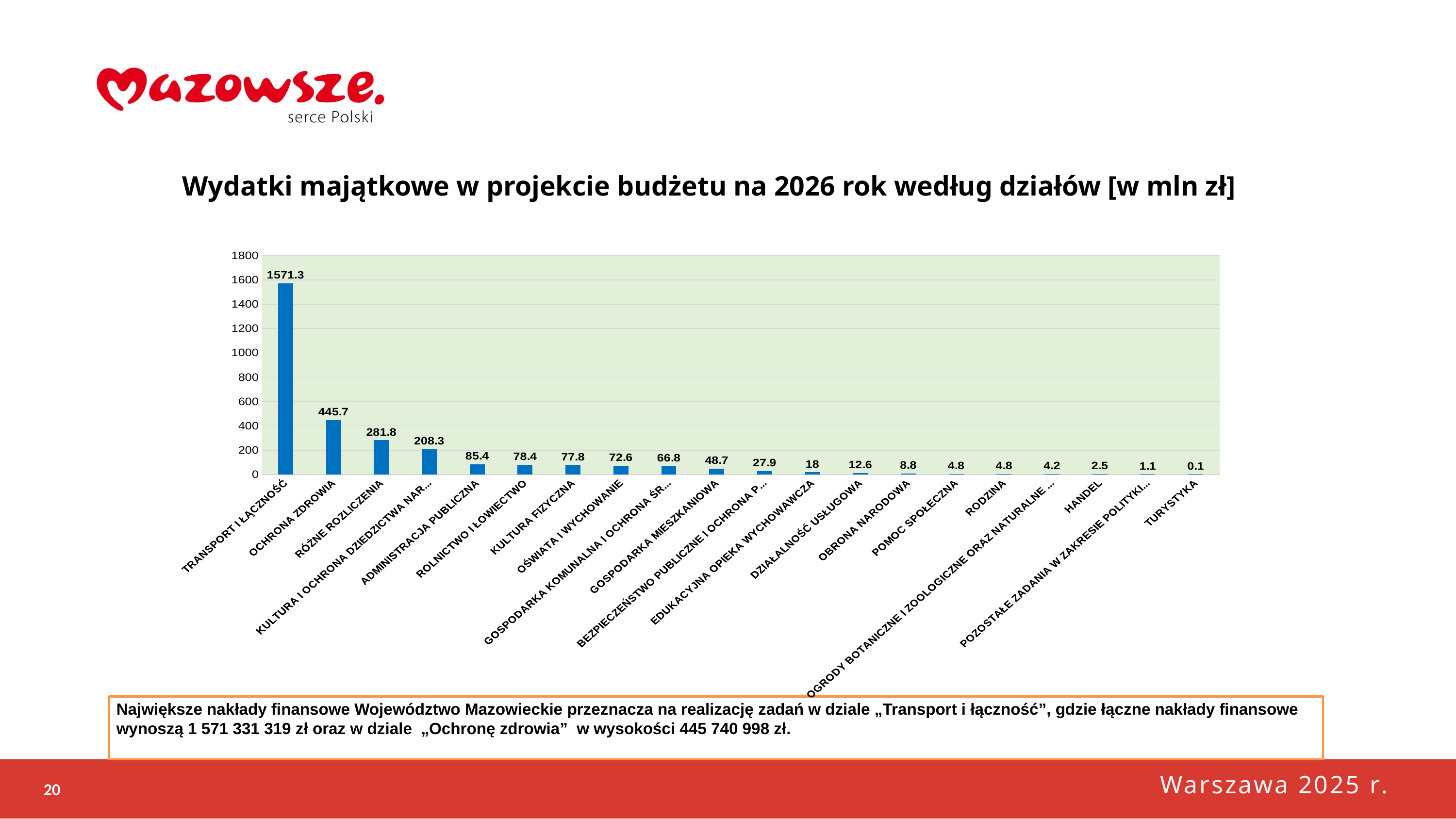
Which category has the lowest value? TURYSTYKA What is the value for ADMINISTRACJA PUBLICZNA? 85.4 What kind of chart is shown on the slide? bar chart What is the difference between the values for TRANSPORT I ŁĄCZNOŚĆ and OCHRONA ZDROWIA? 1125.6 Which is larger, the value for ROLNICTWO I ŁOWIECTWO or the value for GOSPODARKA MIESZKANIOWA? ROLNICTWO I ŁOWIECTWO What is the difference between the values for RÓŻNE ROZLICZENIA and OŚWIATA I WYCHOWANIE? 209.2 What is the value for OCHRONA ZDROWIA? 445.7 What is the title of the chart? Wydatki majątkowe w projekcie budżetu na 2026 rok według działów [w mln zł] How many categories are shown on the chart? 20 What is the value for EDUKACYJNA OPIEKA WYCHOWAWCZA? 18 What is the value for HANDEL? 2.5 Which category has the highest value? TRANSPORT I ŁĄCZNOŚĆ